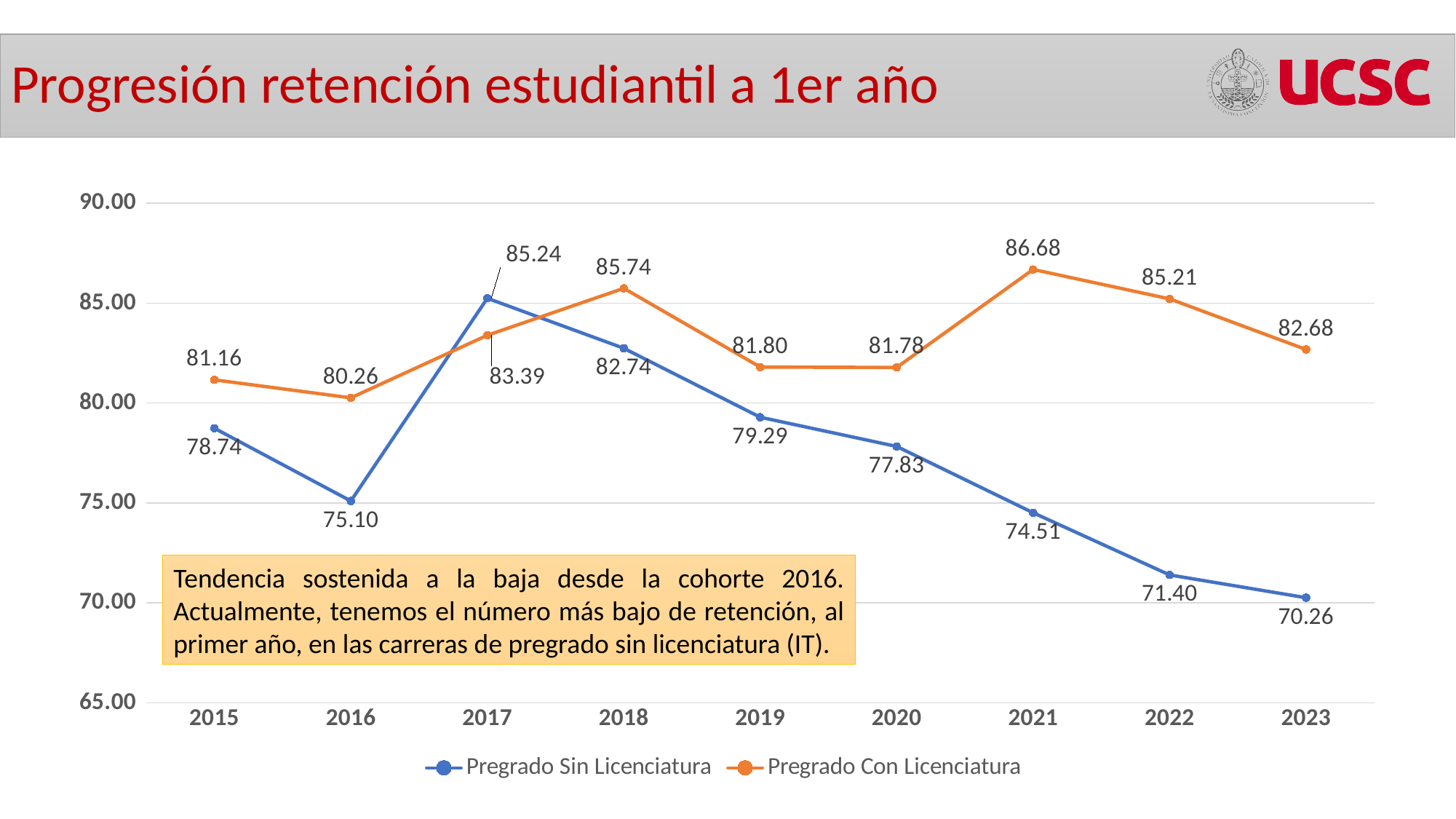
In 2017, which series has the higher value? Pregrado Sin Licenciatura What is the value for Pregrado Sin Licenciatura in 2016? 75.10 What is the title of the slide? Progresión retención estudiantil a 1er año From 2017 to 2023, does the Pregrado Sin Licenciatura line rise or fall? Fall In which year does Pregrado Con Licenciatura reach its highest value? 2021 What is the value for Pregrado Sin Licenciatura in 2023? 70.26 What is the value for Pregrado Con Licenciatura in 2021? 86.68 In which year does Pregrado Sin Licenciatura have its lowest value? 2023 How many years are shown on the x axis? 9 What is the difference between Pregrado Con Licenciatura and Pregrado Sin Licenciatura in 2023? 12.42 What kind of chart is shown on the slide? Line chart How many series does the legend list? 2